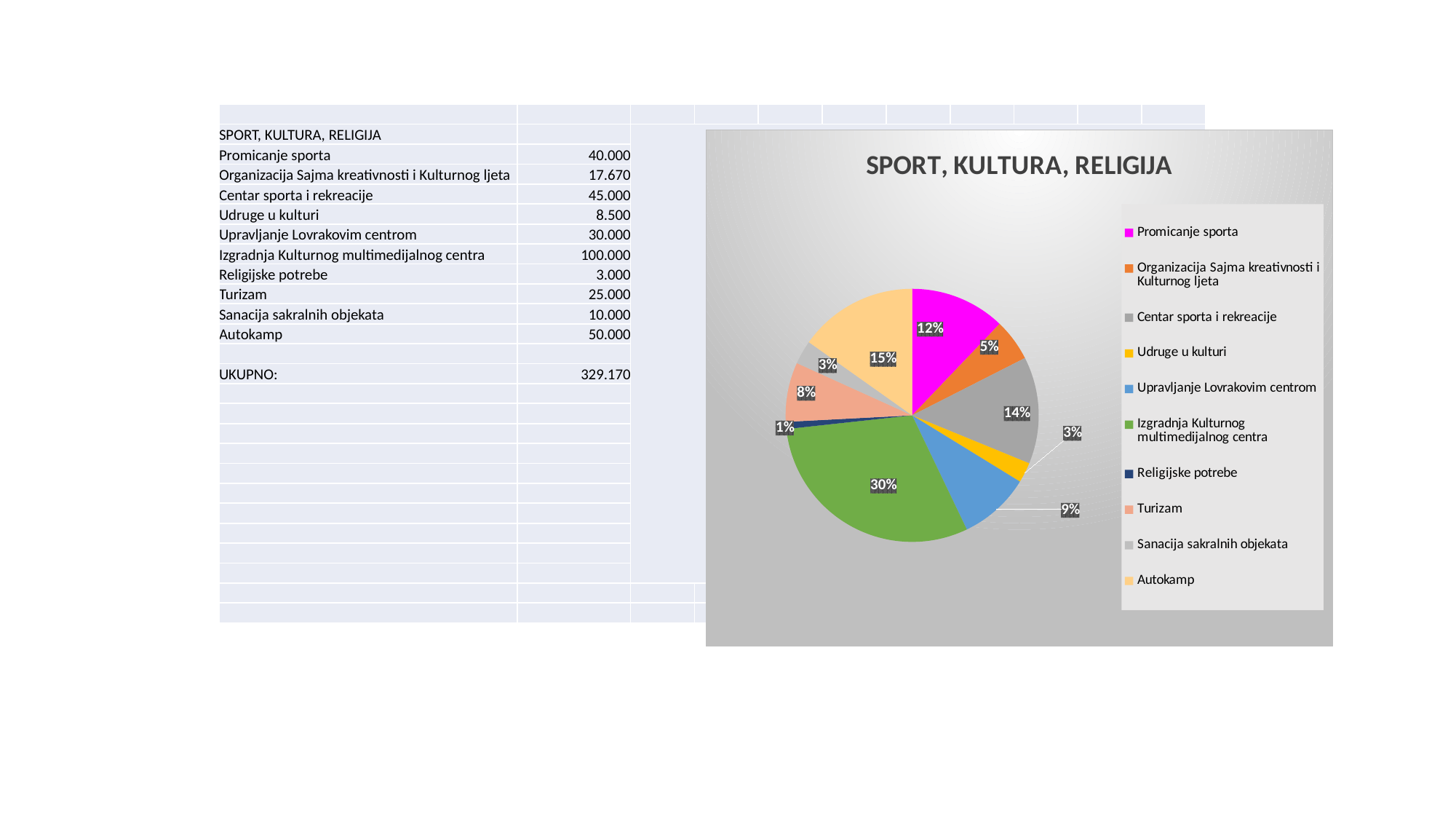
What share of the pie does Promicanje sporta have? 12% What share of the pie does Izgradnja Kulturnog multimedijalnog centra have? 30% Which category has the largest slice of the pie? Izgradnja Kulturnog multimedijalnog centra Which category has the smallest slice of the pie? Religijske potrebe Which slice is larger, Centar sporta i rekreacije or Turizam? Centar sporta i rekreacije What is the difference in percentage points between the Autokamp slice and the Organizacija Sajma kreativnosti i Kulturnog ljeta slice? 10 What kind of chart is shown on the slide? pie chart What is the title of the chart? SPORT, KULTURA, RELIGIJA How many slices does the pie chart have? 10 What share of the pie does Upravljanje Lovrakovim centrom have? 9% What colour is the Izgradnja Kulturnog multimedijalnog centra slice? green